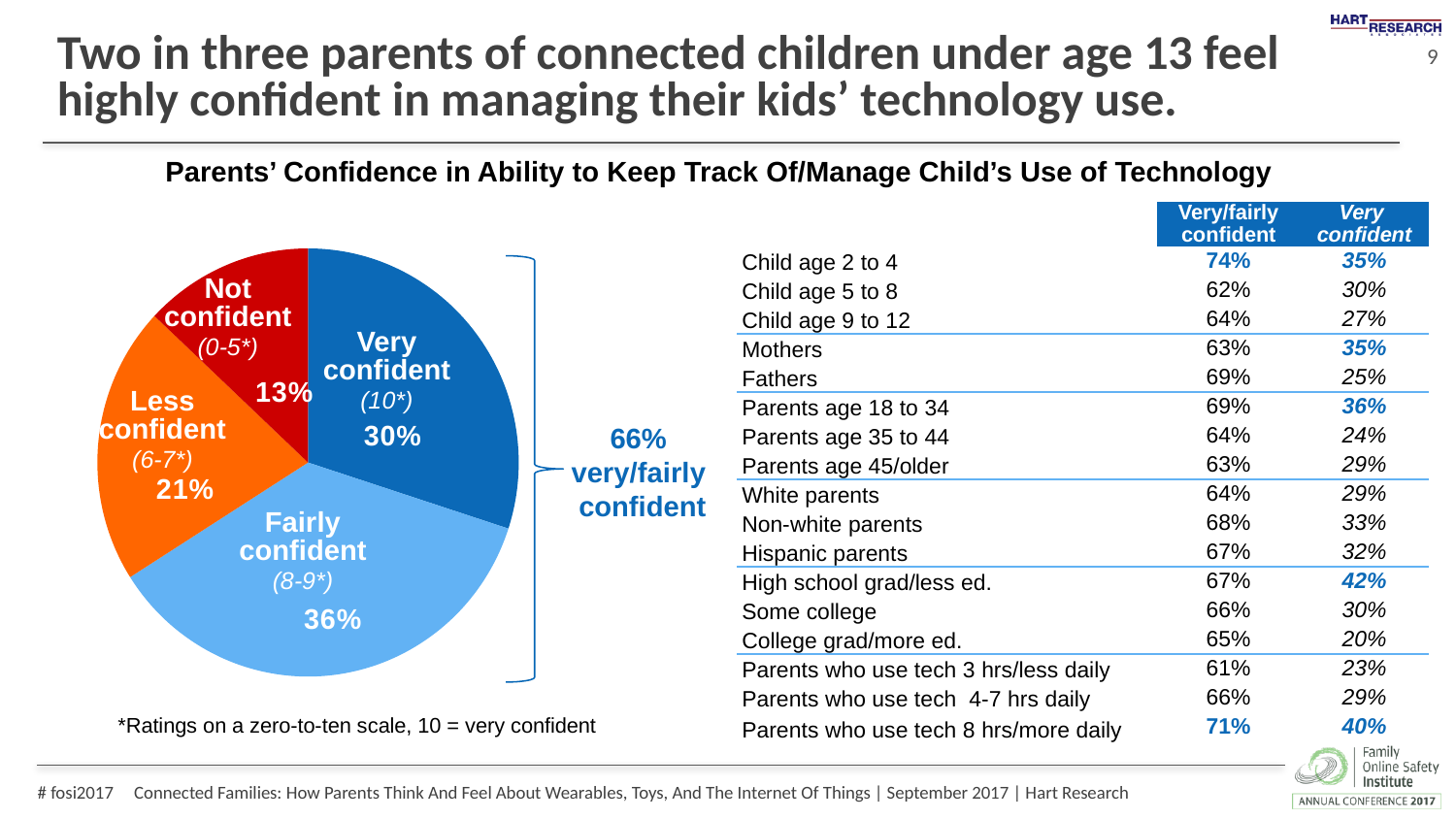
What share of the pie is labelled "Less confident"? 21% What is the difference in percentage points between the "Fairly confident" and "Very confident" slices? 6 Which slice of the pie chart is the largest? Fairly confident What kind of chart is shown on the slide? Pie chart What share of the pie is labelled "Not confident"? 13% Which slice of the pie chart is the smallest? Not confident What rating range on the zero-to-ten scale is shown for the "Fairly confident" slice? 8-9 What combined percentage is shown by the bracket for the "Very confident" and "Fairly confident" slices? 66% Which is larger in the pie chart, "Less confident" or "Not confident"? Less confident How many slices does the pie chart have? 4 What share of the pie is labelled "Fairly confident"? 36%